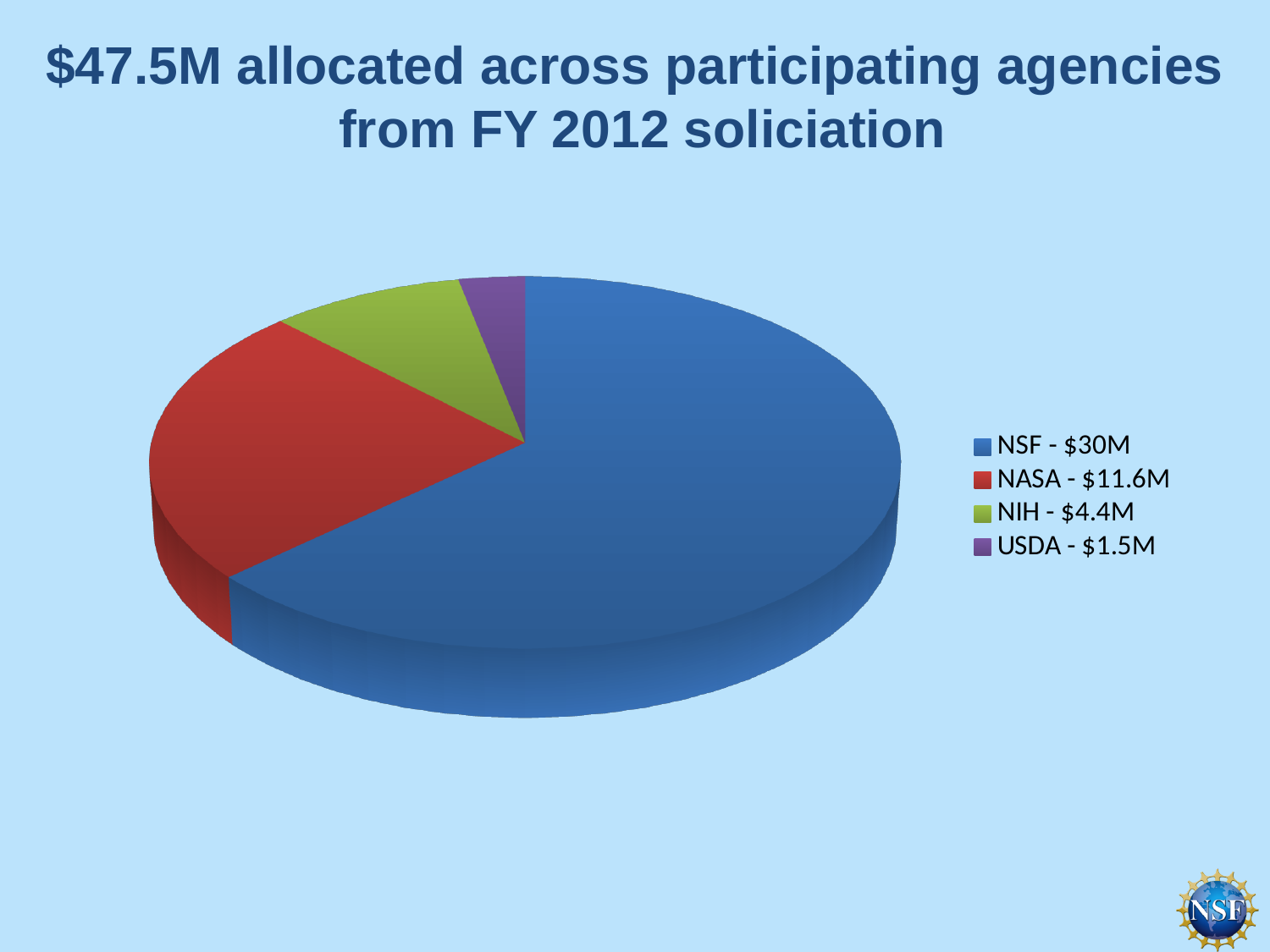
Which received more funding, NIH or USDA? NIH What is the total amount allocated across all agencies, as stated in the title? $47.5M What type of chart is shown on the slide? pie chart How many agencies (slices) does the pie chart show? 4 Which agency received the smallest allocation? USDA Which agency received the largest allocation? NSF How much was allocated to NASA? $11.6M How much was allocated to NSF according to the legend? $30M What is the difference between the NSF and NASA allocations? $18.4M How much was allocated to NIH? $4.4M How much was allocated to USDA? $1.5M Which colour represents NASA in the pie chart? red